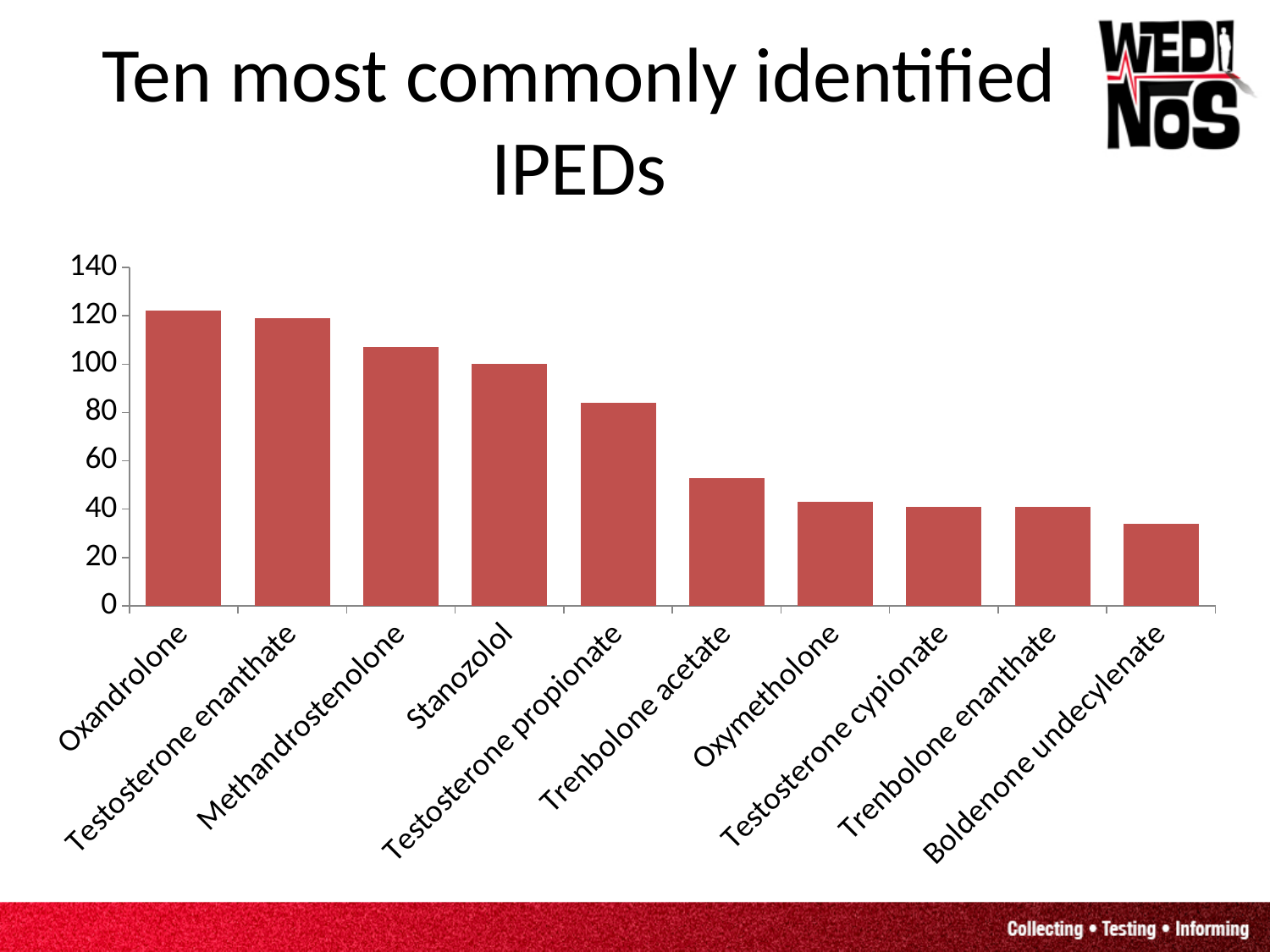
Which IPED has the highest value on the chart? Oxandrolone Is the value for Oxandrolone greater or less than 100? greater Do the values rise or fall moving from left to right along the x axis? Fall What kind of chart is shown on the slide? Bar chart Is the value for Testosterone propionate greater or less than 100? less How many categories (IPEDs) are plotted on the chart? 10 Is the value for Trenbolone acetate greater or less than 60? less Which IPED has the lowest value on the chart? Boldenone undecylenate What is the title of the slide containing the chart? Ten most commonly identified IPEDs Which has the larger value, Methandrostenolone or Testosterone propionate? Methandrostenolone